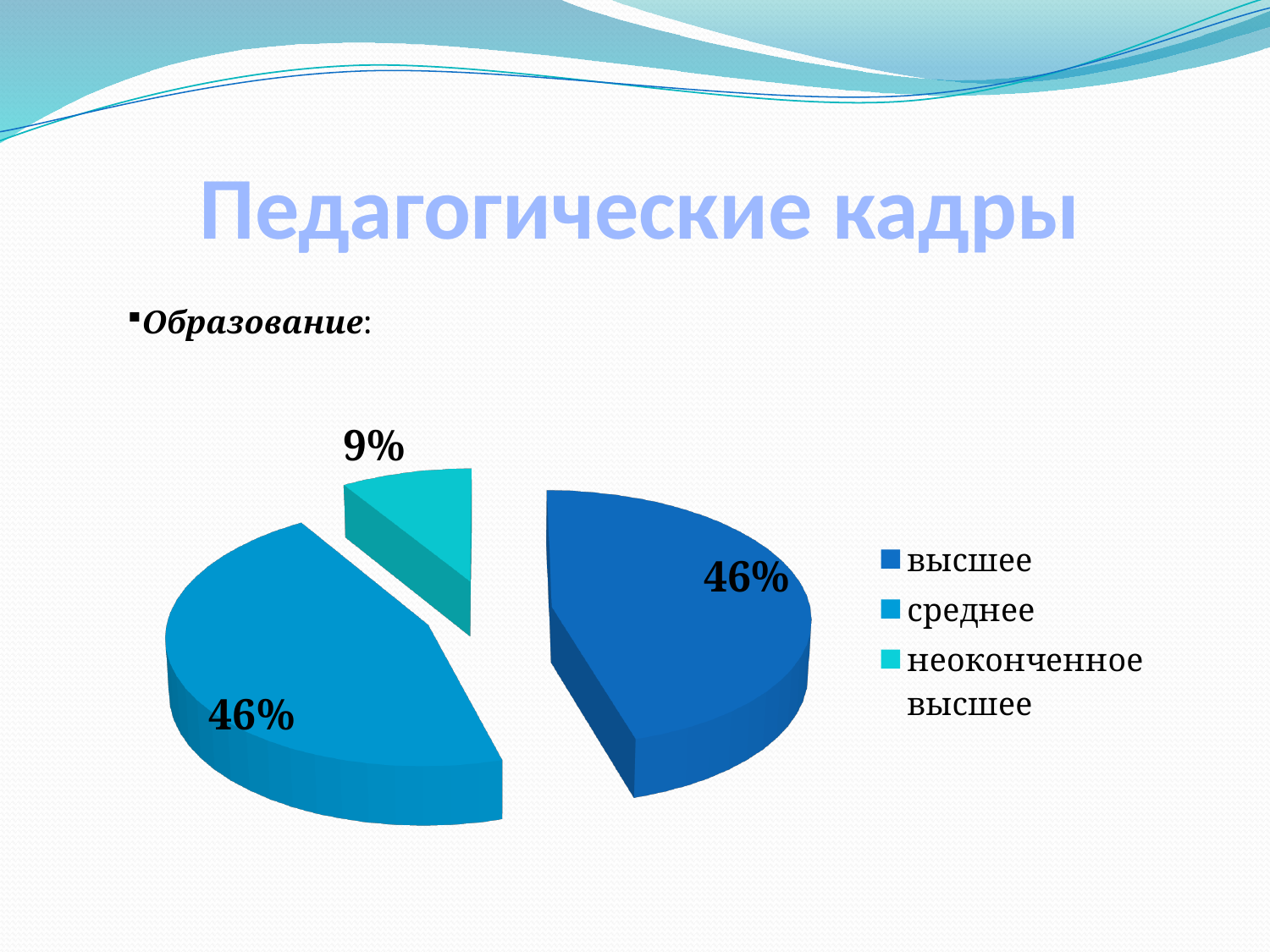
What is the difference in percentage points between the "высшее" slice and the "неоконченное высшее" slice? 37 How many entries does the legend list? 3 What is the title of the slide containing the pie chart? Педагогические кадры How many slices does the pie chart have? 3 What share of the pie does the "высшее" slice represent? 46% Which slice is larger, "среднее" or "неоконченное высшее"? среднее Which category has the smallest slice of the pie? неоконченное высшее What kind of chart is shown on the slide? pie chart Which legend entry is shown in the lightest (teal) colour? неоконченное высшее What share of the pie does the "неоконченное высшее" slice represent? 9% What share of the pie does the "среднее" slice represent? 46% Is the share for "неоконченное высшее" greater or less than 10%? less